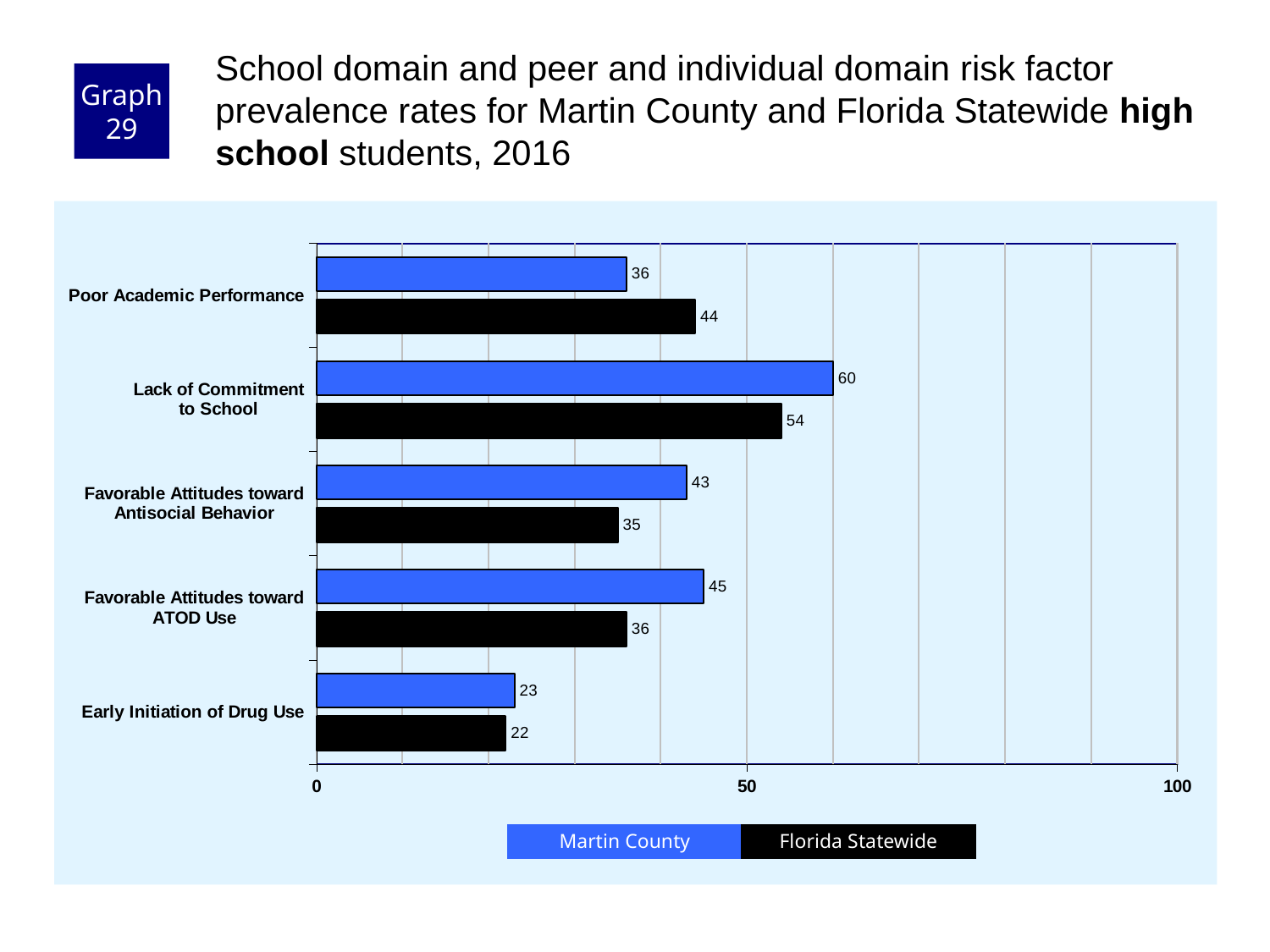
What is the Martin County value for Lack of Commitment to School? 60 How many risk factor categories are shown on the chart? 5 Is the Martin County value for Lack of Commitment to School greater or less than 50? greater For Poor Academic Performance, which is larger: the Martin County value or the Florida Statewide value? Florida Statewide What kind of chart is shown on the slide? bar chart How many series does the legend list? 2 What is the Florida Statewide value for Early Initiation of Drug Use? 22 What is the difference between the Martin County and Florida Statewide values for Favorable Attitudes toward ATOD Use? 9 Which risk factor has the highest Martin County value? Lack of Commitment to School What is the Florida Statewide value for Poor Academic Performance? 44 Which risk factor has the lowest Florida Statewide value? Early Initiation of Drug Use Which colour represents Florida Statewide in the chart? black